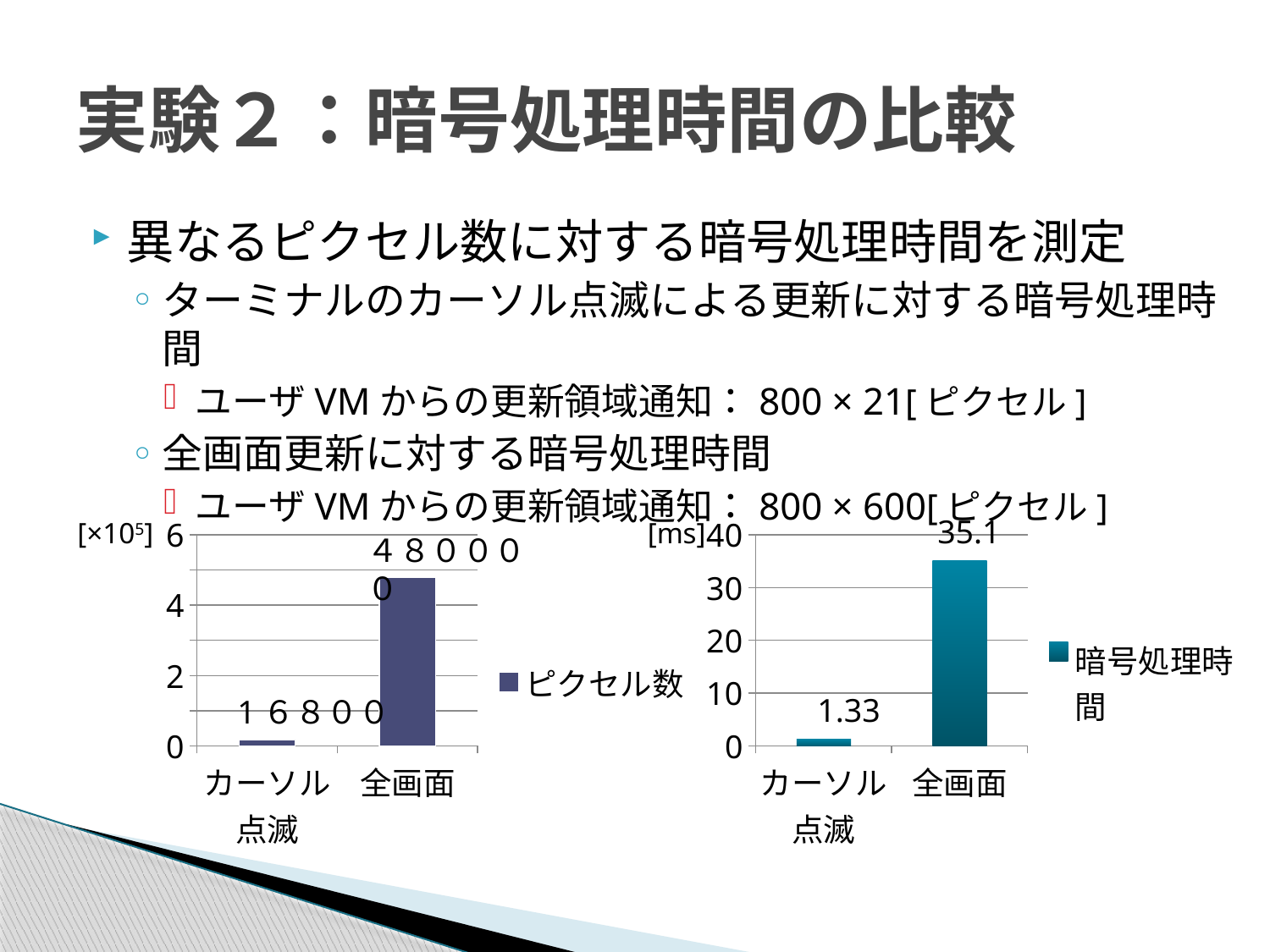
In the right chart (暗号処理時間), is the value for 全画面 greater or less than 30? greater In the right chart (暗号処理時間), which category has the highest value? 全画面 In the right chart (暗号処理時間), what is the value for 全画面? 35.1 In the left chart (ピクセル数), what is the value for カーソル点滅? 16800 What kind of chart is the left chart (ピクセル数)? bar chart In the left chart (ピクセル数), which category has the lowest value? カーソル点滅 In the left chart (ピクセル数), what is the difference between the values for 全画面 and カーソル点滅? 463200 What unit is shown on the vertical axis of the right chart (暗号処理時間)? [ms] In the right chart (暗号処理時間), what is the difference between the values for 全画面 and カーソル点滅? 33.77 How many categories are shown in the right chart (暗号処理時間)? 2 In the left chart (ピクセル数), what is the value for 全画面? 480000 In the right chart (暗号処理時間), what is the value for カーソル点滅? 1.33